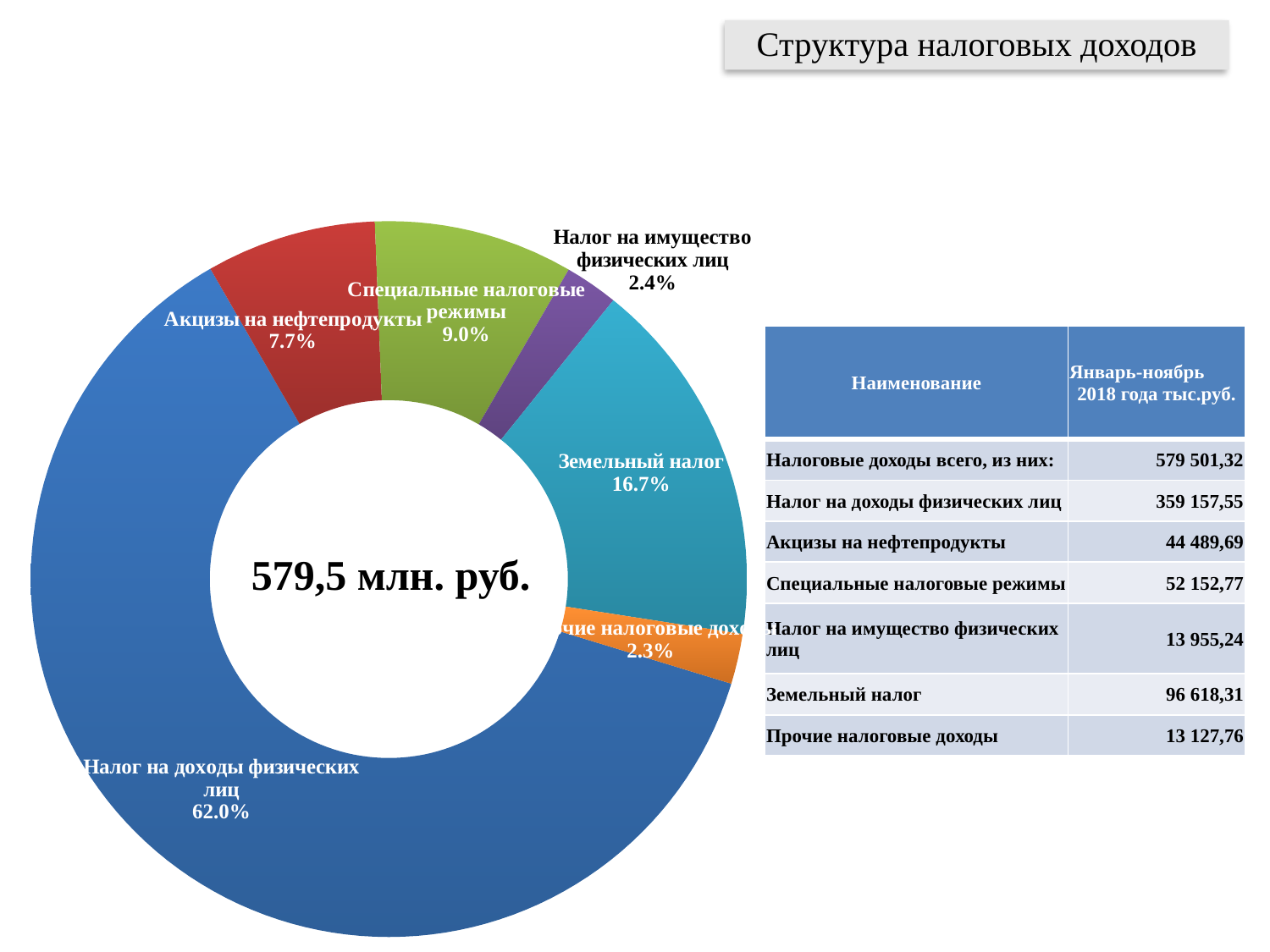
What share of the pie does Земельный налог represent? 16.7% Which category has the largest slice of the pie? Налог на доходы физических лиц What kind of chart is shown on the slide? Pie chart (doughnut) What share of the pie does Налог на имущество физических лиц represent? 2.4% Which category has the smallest slice of the pie? Прочие налоговые доходы What share of the pie does Акцизы на нефтепродукты represent? 7.7% What total value is printed in the centre of the doughnut chart? 579,5 млн. руб. How many categories are shown in the pie chart? 6 What is the difference in percentage points between the shares of Налог на доходы физических лиц and Земельный налог? 45.3% Which has a larger share: Специальные налоговые режимы or Акцизы на нефтепродукты? Специальные налоговые режимы